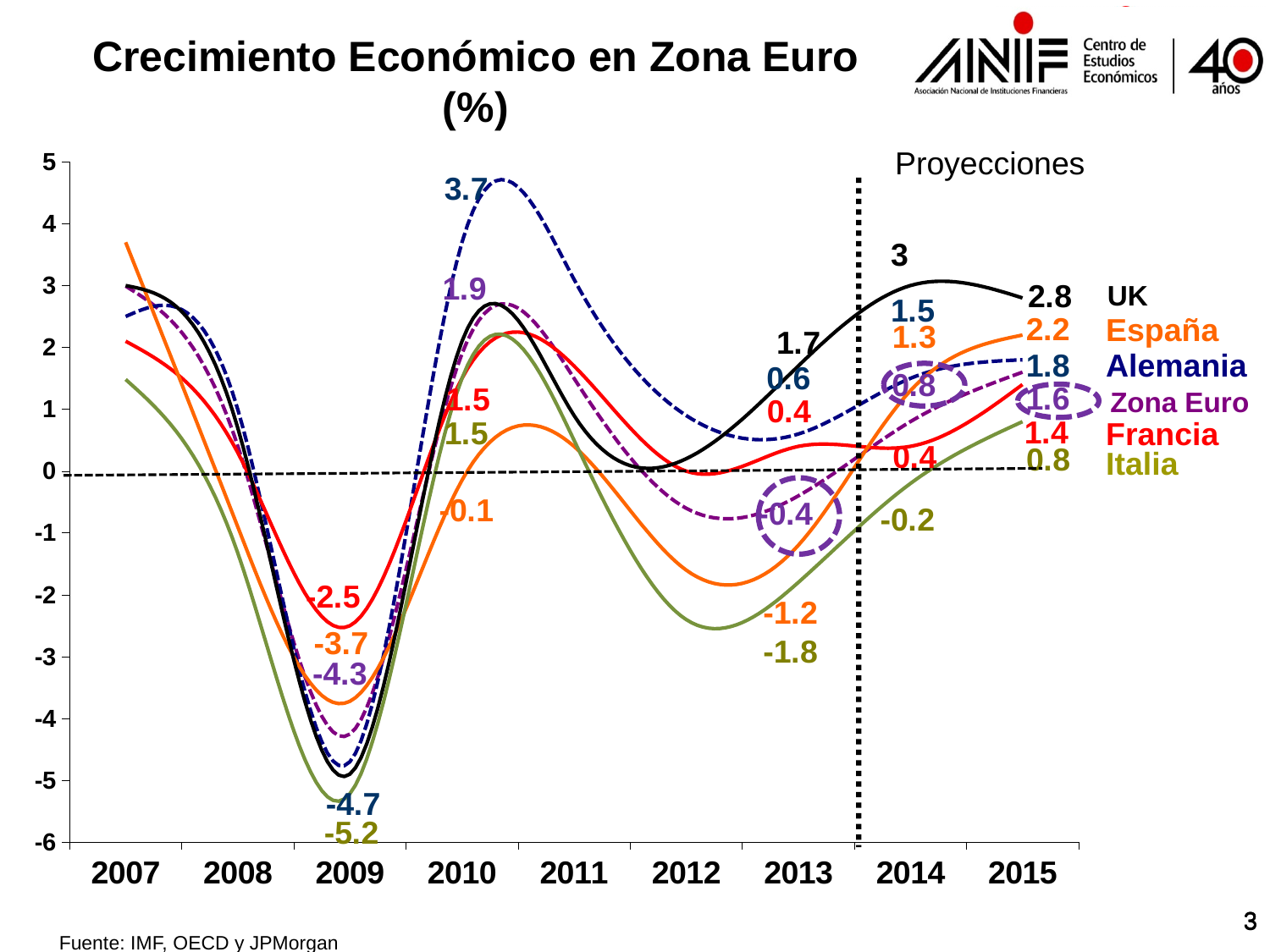
How many series (countries/regions) are listed in the chart legend? 6 Which series has the highest projected value in 2015? UK Which series has the lowest value in 2009? Italia What kind of chart is shown on the slide? line chart In 2014, which is larger: the value for UK or the value for Alemania? UK What is the projected growth value for España in 2015? 2.2 What is the projected value for Italia in 2014? -0.2 What label is written above the vertical dotted line that separates the projection period? Proyecciones What is the value for Zona Euro in 2013? -0.4 What is the growth value for Alemania in 2010? 3.7 What is the difference between the 2015 values for UK (2.8) and Italia (0.8)? 2 What is the projected growth value for UK in 2015? 2.8